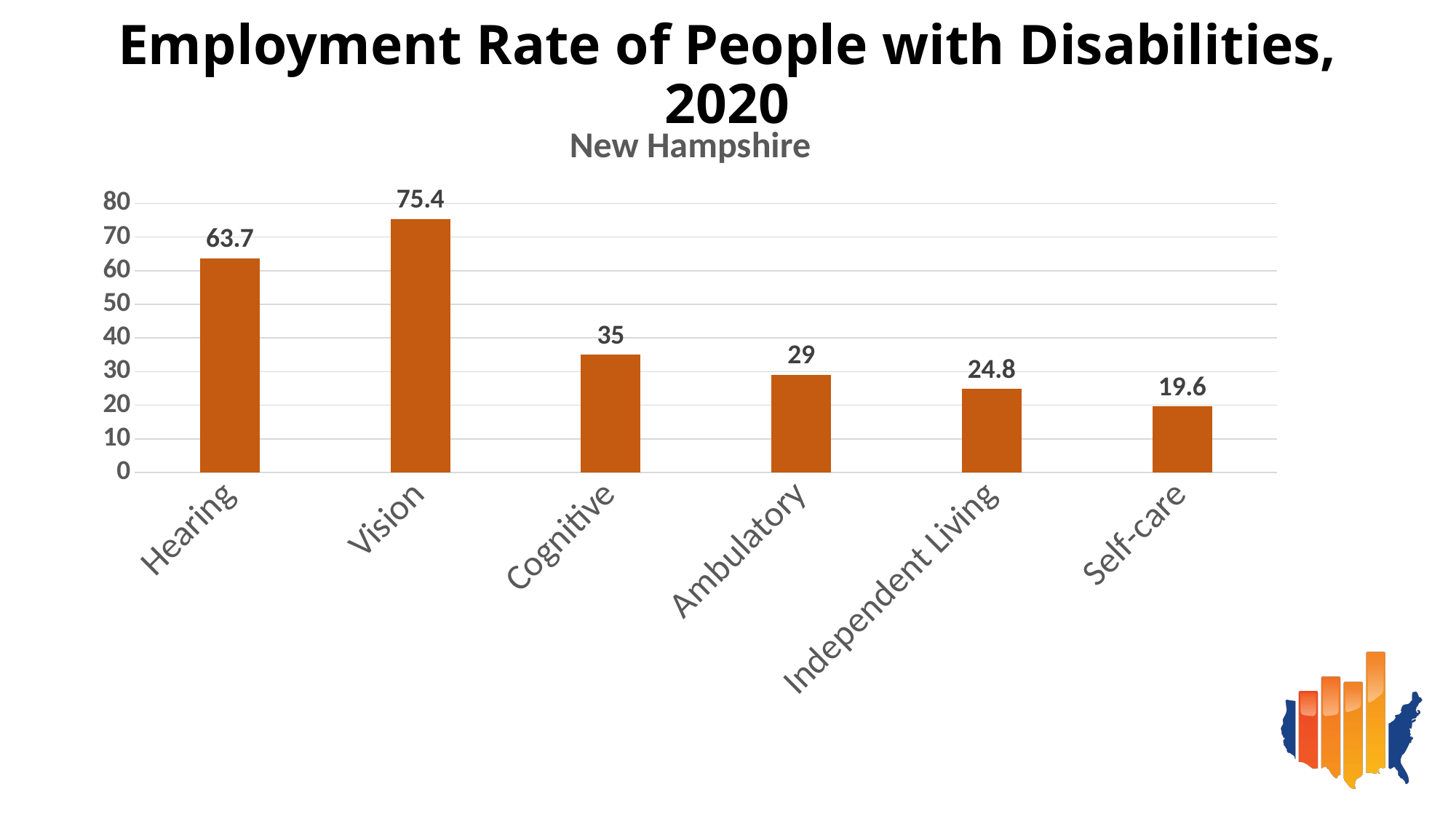
Which state does the chart's subtitle say the data is for? New Hampshire What is the difference between the employment rates for Cognitive and Ambulatory? 6 What is the employment rate for people with a hearing disability? 63.7 What kind of chart is shown on the slide? Bar chart What is the difference between the employment rates for Vision and Hearing? 11.7 What is the employment rate for the Independent Living category? 24.8 Which disability category has the highest employment rate? Vision What is the employment rate for people with a vision disability? 75.4 Which has a higher employment rate, Ambulatory or Self-care? Ambulatory How many disability categories are shown on the chart? 6 What is the employment rate for people with a cognitive disability? 35 Which disability category has the lowest employment rate? Self-care